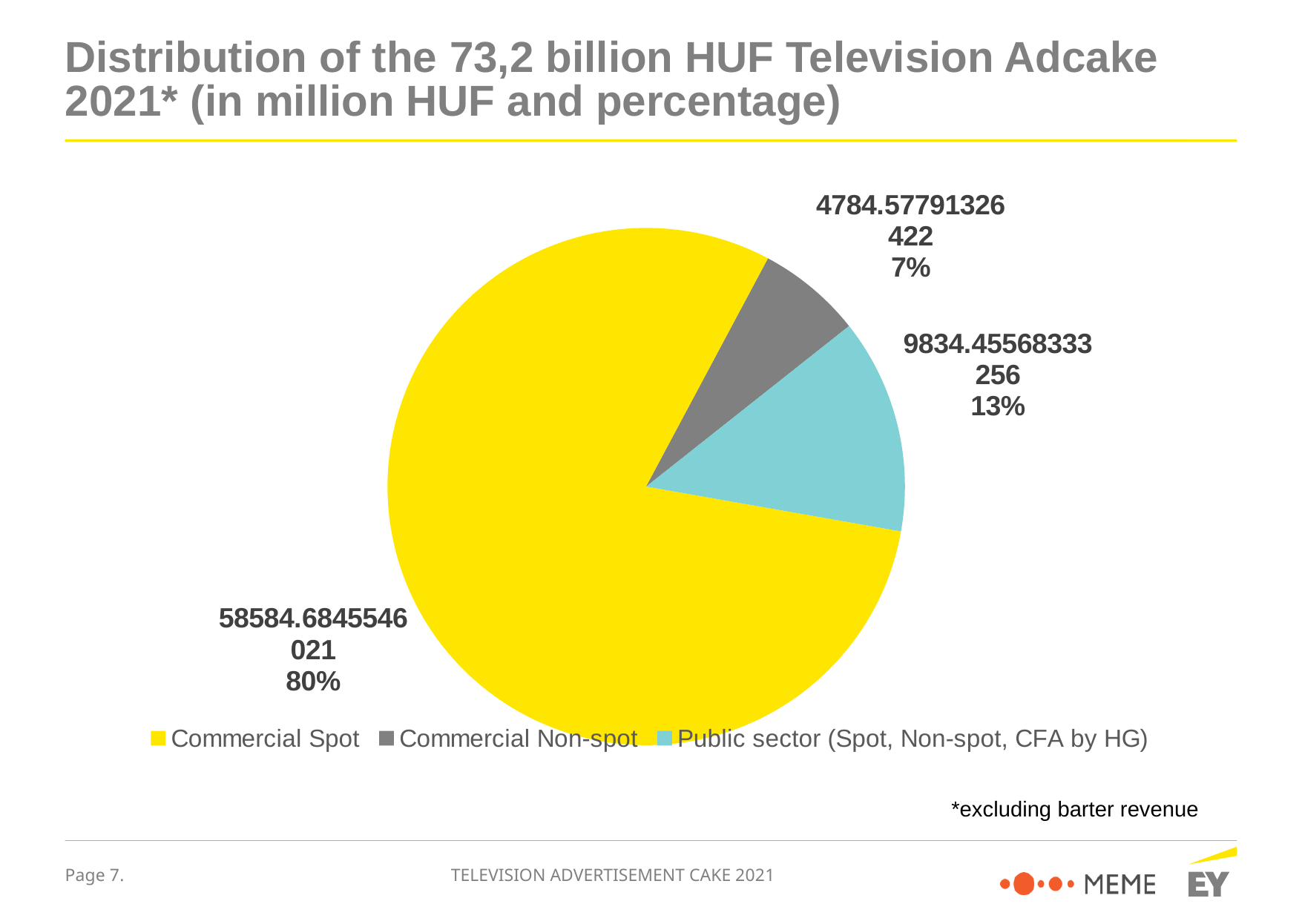
What percentage share of the pie does Public sector (Spot, Non-spot, CFA by HG) hold? 13% How many slices does the pie chart have? 3 How many entries does the legend list? 3 What type of chart is shown on the slide? pie chart What colour is the Commercial Spot slice? yellow What percentage share of the pie does Commercial Non-spot hold? 7% Which is larger, the share for Public sector (Spot, Non-spot, CFA by HG) or the share for Commercial Non-spot? Public sector (Spot, Non-spot, CFA by HG) What percentage share of the pie does Commercial Spot hold? 80% What is the difference in percentage points between the Public sector (Spot, Non-spot, CFA by HG) share and the Commercial Non-spot share? 6 percentage points Which category has the largest slice of the pie? Commercial Spot What is the difference in percentage points between the Commercial Spot share and the Public sector (Spot, Non-spot, CFA by HG) share? 67 percentage points Which category has the smallest slice of the pie? Commercial Non-spot